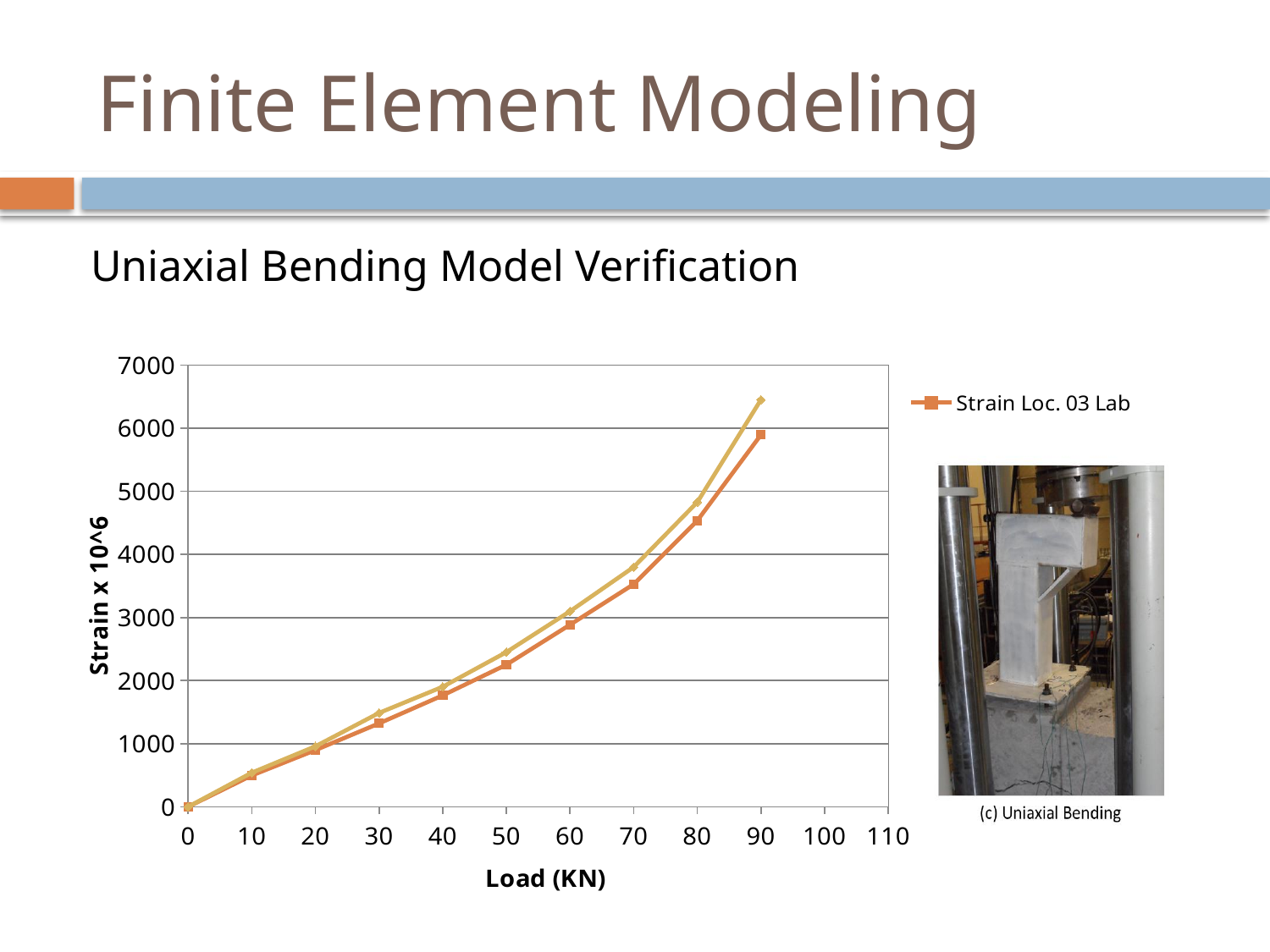
Does the Strain Loc. 03 Lab series rise or fall as the load increases? Rises Is the Strain Loc. 03 Lab value at a load of 80 KN greater or less than 4000? greater What is the title of the y axis of the chart? Strain x 10^6 At which load does the Strain Loc. 03 Lab series reach its highest value? 90 Is the Strain Loc. 03 Lab value at a load of 70 KN greater or less than 3000? greater Is the Strain Loc. 03 Lab value at a load of 30 KN greater or less than 1000? greater How many data points does the Strain Loc. 03 Lab series have? 10 What is the title of the x axis of the chart? Load (KN) What kind of chart is shown on the slide? Line chart How many series does the chart's legend list? 1